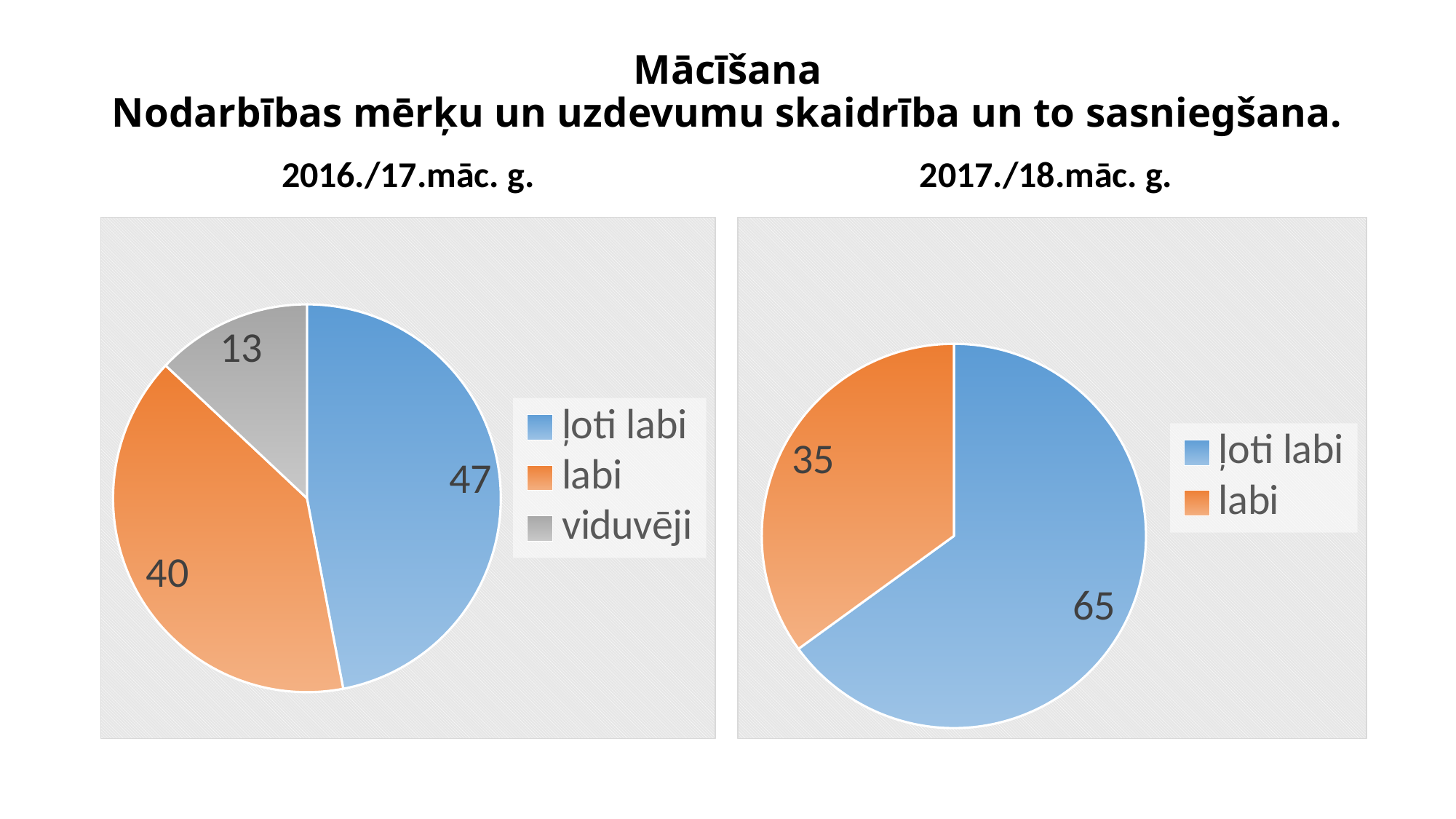
In the 2016./17.māc. g. pie chart, what is the value for ļoti labi? 47 How many slices does the 2016./17.māc. g. pie chart have? 3 In the 2017./18.māc. g. pie chart, which is larger, ļoti labi or labi? ļoti labi In the 2017./18.māc. g. pie chart, what is the value for labi? 35 In the 2017./18.māc. g. pie chart, what is the value for ļoti labi? 65 How many entries does the legend of the 2017./18.māc. g. chart list? 2 In the 2016./17.māc. g. pie chart, which category has the smallest slice? viduvēji In the 2016./17.māc. g. pie chart, what is the difference between labi and viduvēji? 27 What kind of chart is the 2017./18.māc. g. chart? pie chart In the 2017./18.māc. g. pie chart, what is the difference between ļoti labi and labi? 30 In the 2016./17.māc. g. pie chart, what is the value for viduvēji? 13 In the 2016./17.māc. g. pie chart, which category has the largest slice? ļoti labi